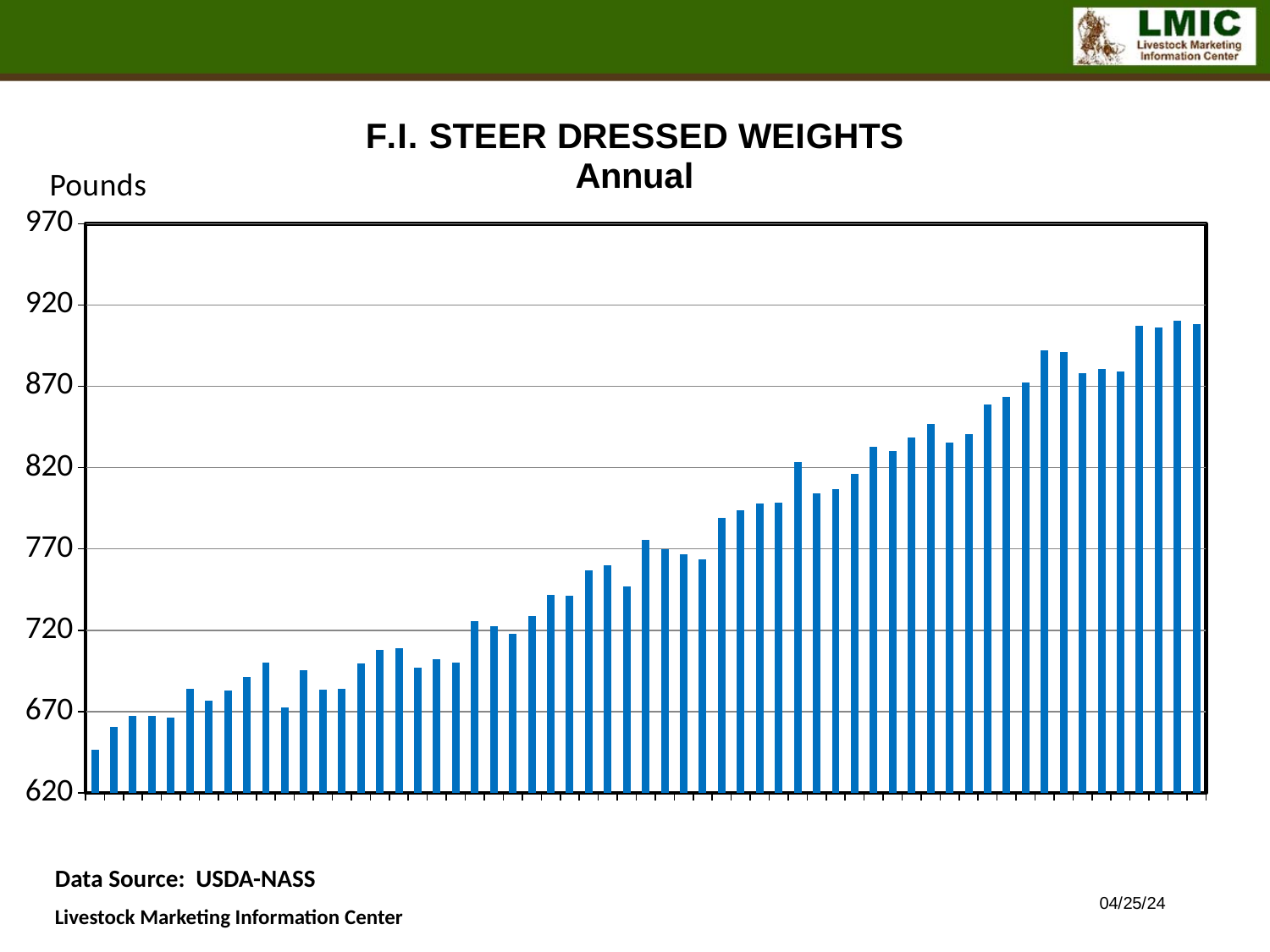
Is the value of the tallest bar greater or less than 920? less What is the title of the chart? F.I. STEER DRESSED WEIGHTS Annual Which is larger, the leftmost bar or the rightmost bar? the rightmost bar Is the value of the rightmost bar greater or less than 870? greater Do the dressed weights generally rise or fall from left to right across the chart? rise What kind of chart is shown on the slide? bar chart Is the value of the rightmost bar greater or less than 920? less What unit is shown on the vertical axis of the chart? Pounds What is the lowest value shown on the vertical axis? 620 Which bar is the lowest on the chart? the leftmost (first) bar